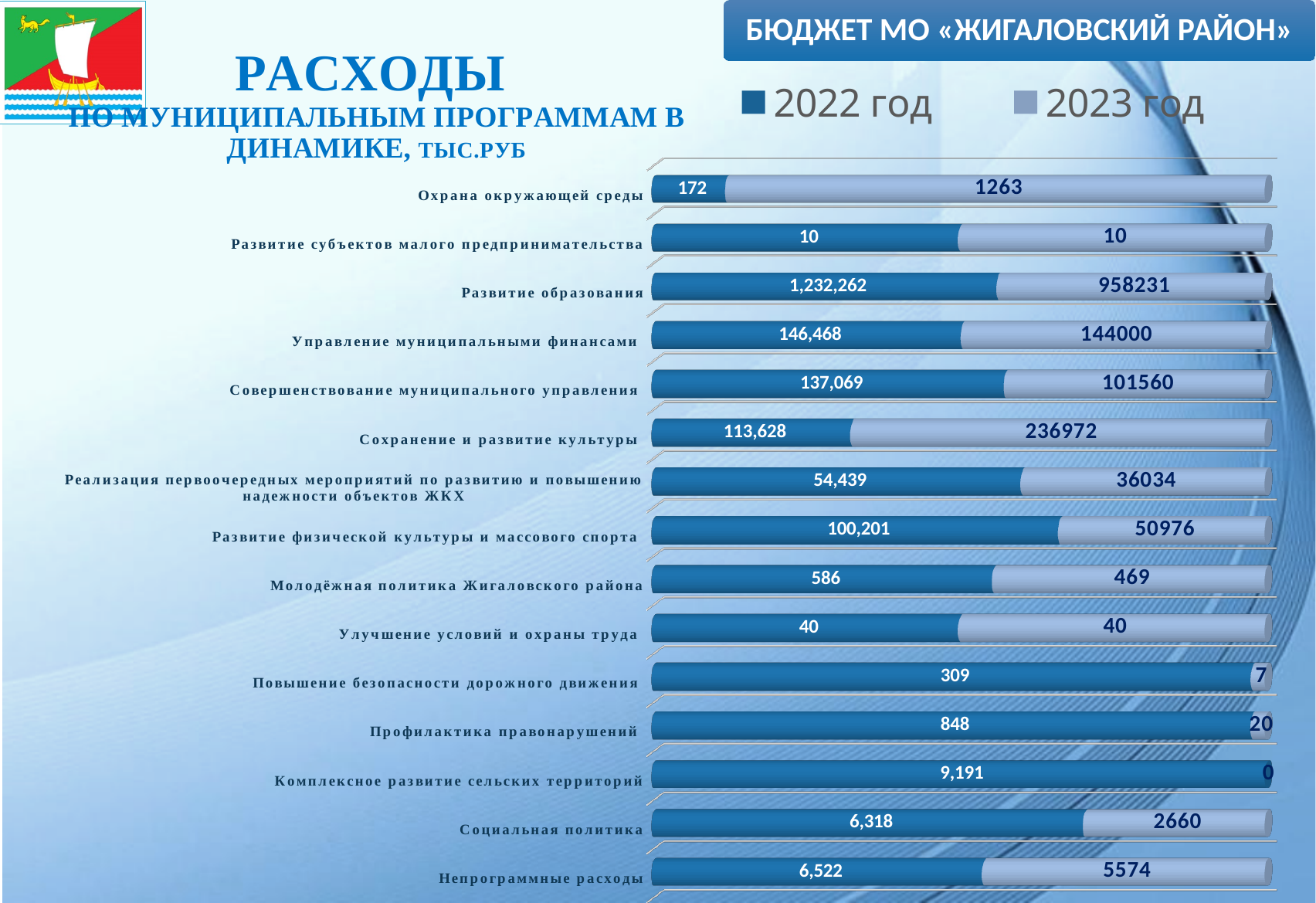
What is the difference between the 2023 год and 2022 год values for Охрана окружающей среды? 1091 For Повышение безопасности дорожного движения, which year has the larger value, 2022 год or 2023 год? 2022 год What is the 2023 год value for Сохранение и развитие культуры? 236972 What is the 2022 год value for Профилактика правонарушений? 848 What is the difference between the 2022 год and 2023 год values for Молодёжная политика Жигаловского района? 117 How many series does the legend list? 2 What is the 2022 год value for Развитие образования? 1,232,262 Which category has the lowest 2023 год value? Комплексное развитие сельских территорий Which category has the highest 2023 год value? Развитие образования What is the 2023 год value for Охрана окружающей среды? 1263 How many categories are shown in the chart? 15 What is the 2023 год value for Комплексное развитие сельских территорий? 0